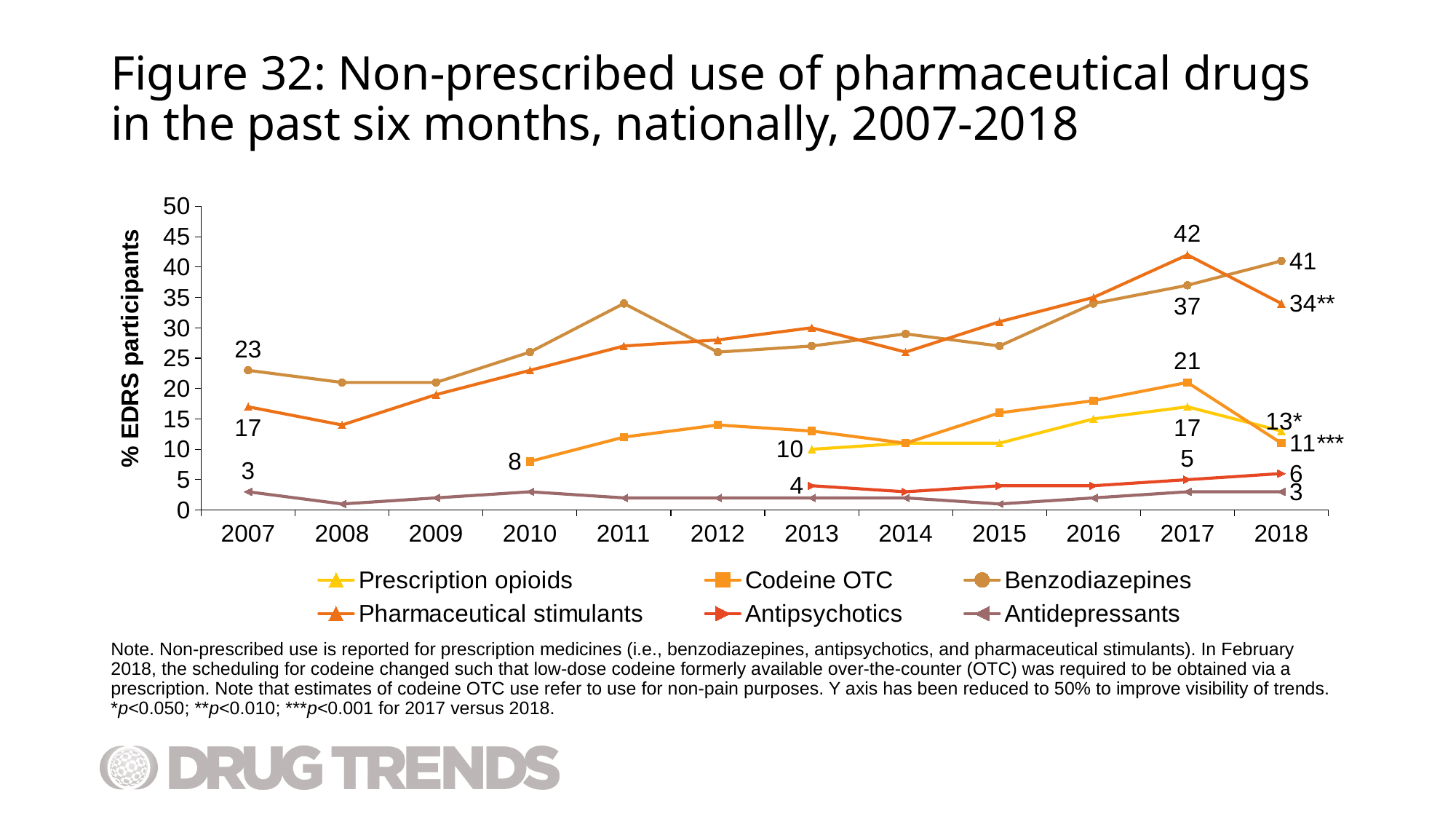
How many series does the legend list? 6 What is the value for Codeine OTC in 2010? 8 In 2018, which is larger: Benzodiazepines or Pharmaceutical stimulants? Benzodiazepines Which series has the highest value in 2017? Pharmaceutical stimulants What is the value for Antidepressants in 2007? 3 What is the difference between the Codeine OTC values in 2017 and 2018? 10 Is the value for Benzodiazepines in 2011 greater or less than 30? greater What is the value for Benzodiazepines in 2018? 41 What is the difference between the Pharmaceutical stimulants values in 2017 and 2018? 8 What kind of chart is shown? line chart How many years are shown on the x axis? 12 What is the value for Pharmaceutical stimulants in 2017? 42